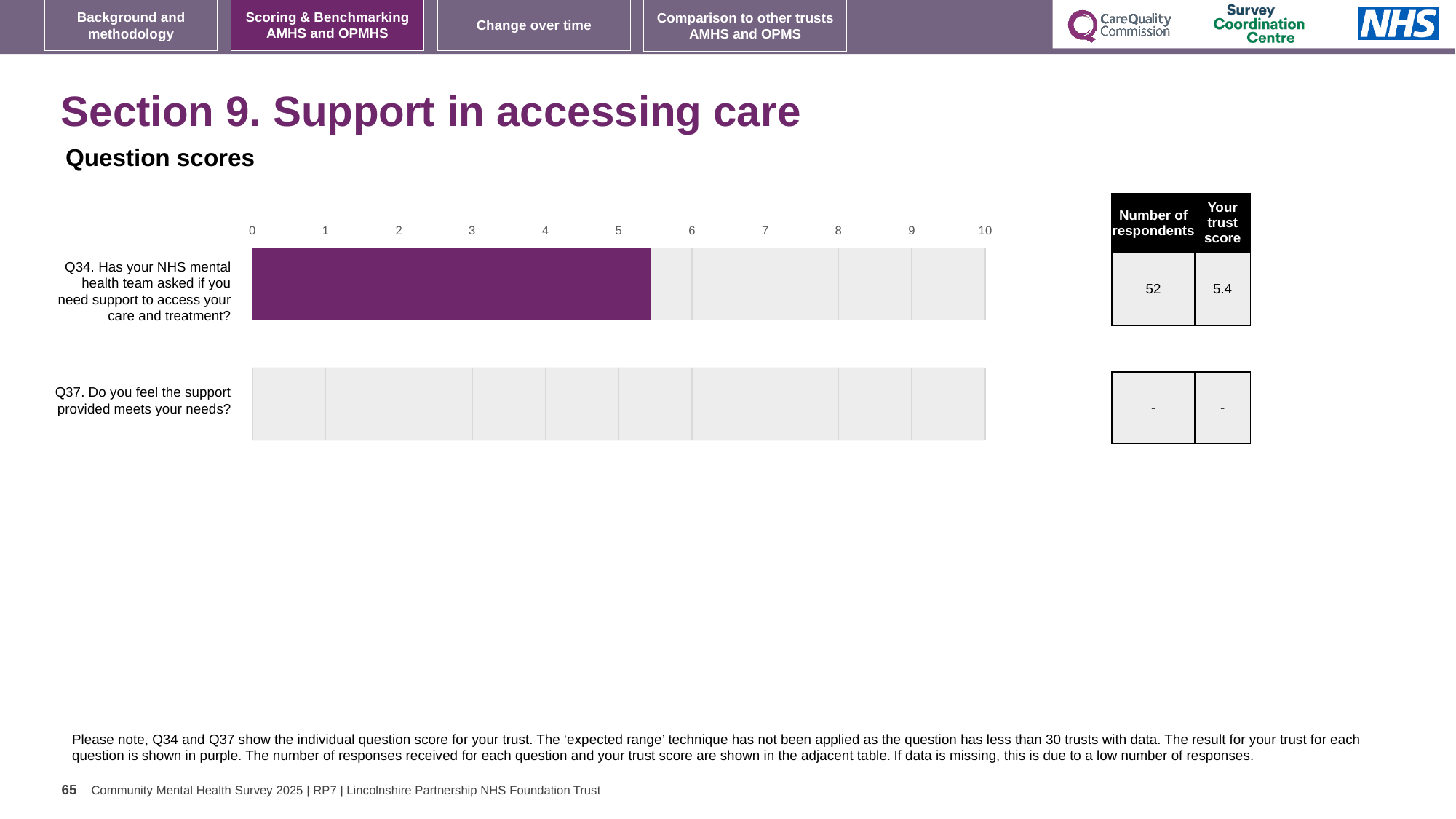
What is the maximum value shown on the chart's axis? 10 Is the value for Q34 greater or less than 5? greater What kind of chart is used to show the question scores? bar chart What is shown as the trust score for Q37 (Do you feel the support provided meets your needs?)? - What is the trust score for Q34 (Has your NHS mental health team asked if you need support to access your care and treatment?)? 5.4 How many respondents answered Q34? 52 Which question has a plotted bar on the chart? Q34 Is the value for Q34 greater or less than 6? less Which question has the higher score, Q34 or Q37? Q34 How many questions are listed on the chart? 2